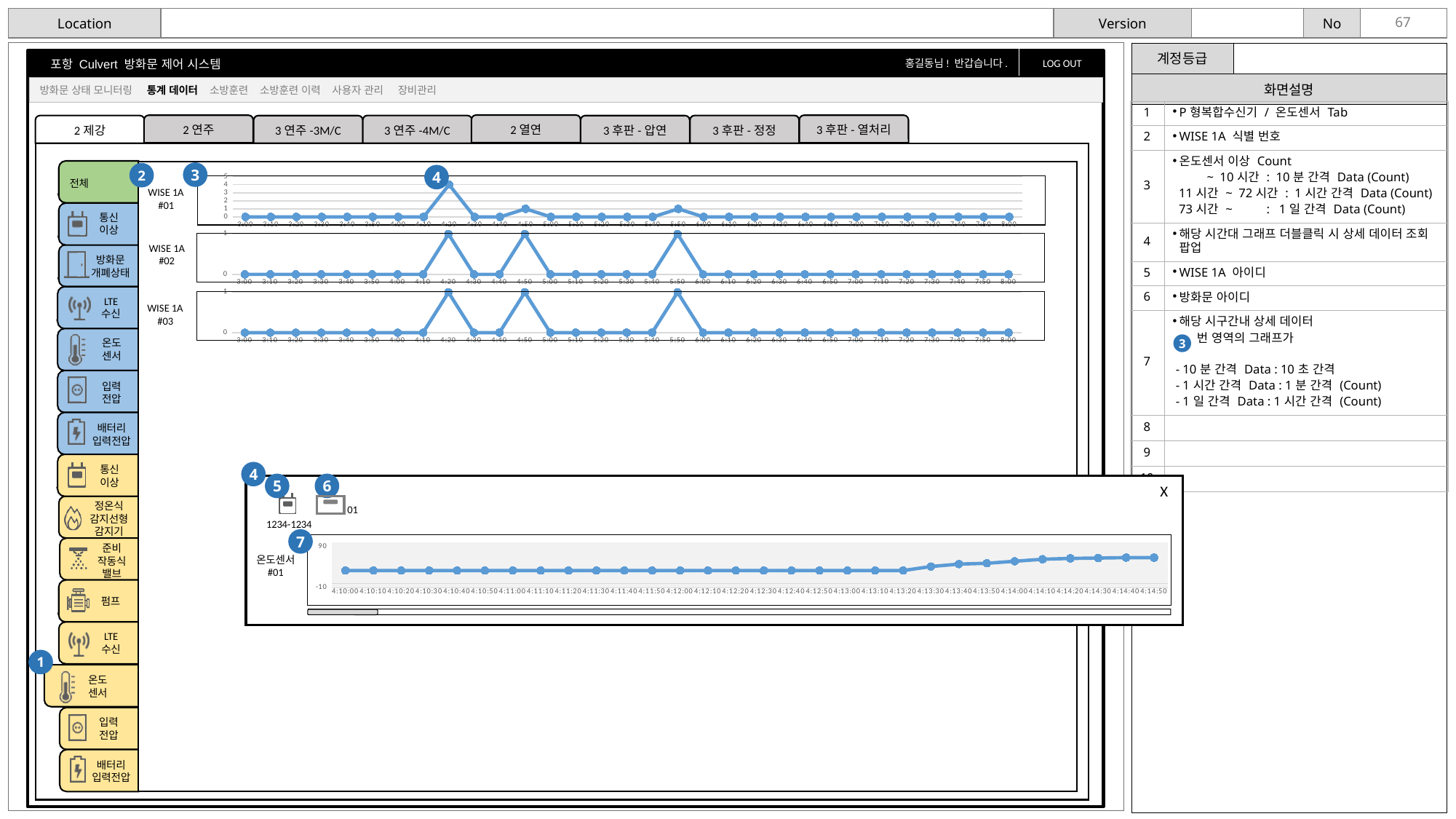
In the WISE 1A #03 chart, what is the value at 5:50? 1 What is the highest tick value on the y axis of the WISE 1A #01 chart? 5 What kind of chart is the WISE 1A #02 chart? line chart How many line charts are shown on the slide in total, including the popup? 4 In the popup chart 온도센서 #01, do the values rise or fall toward the right end of the x axis? rise In the WISE 1A #02 chart, how many times does the line rise to 1? 3 In the WISE 1A #02 chart, which is larger, the value at 4:20 or the value at 4:30? 4:20 In the popup chart 온도센서 #01, is the value at 4:14:50 greater or less than 90? less In the WISE 1A #01 chart, at which time is the value highest? 4:20 In the WISE 1A #02 chart, what is the value at 3:00? 0 In the WISE 1A #03 chart, what is the difference between the value at 4:50 and the value at 5:00? 1 In the WISE 1A #02 chart, what is the value at 4:20? 1